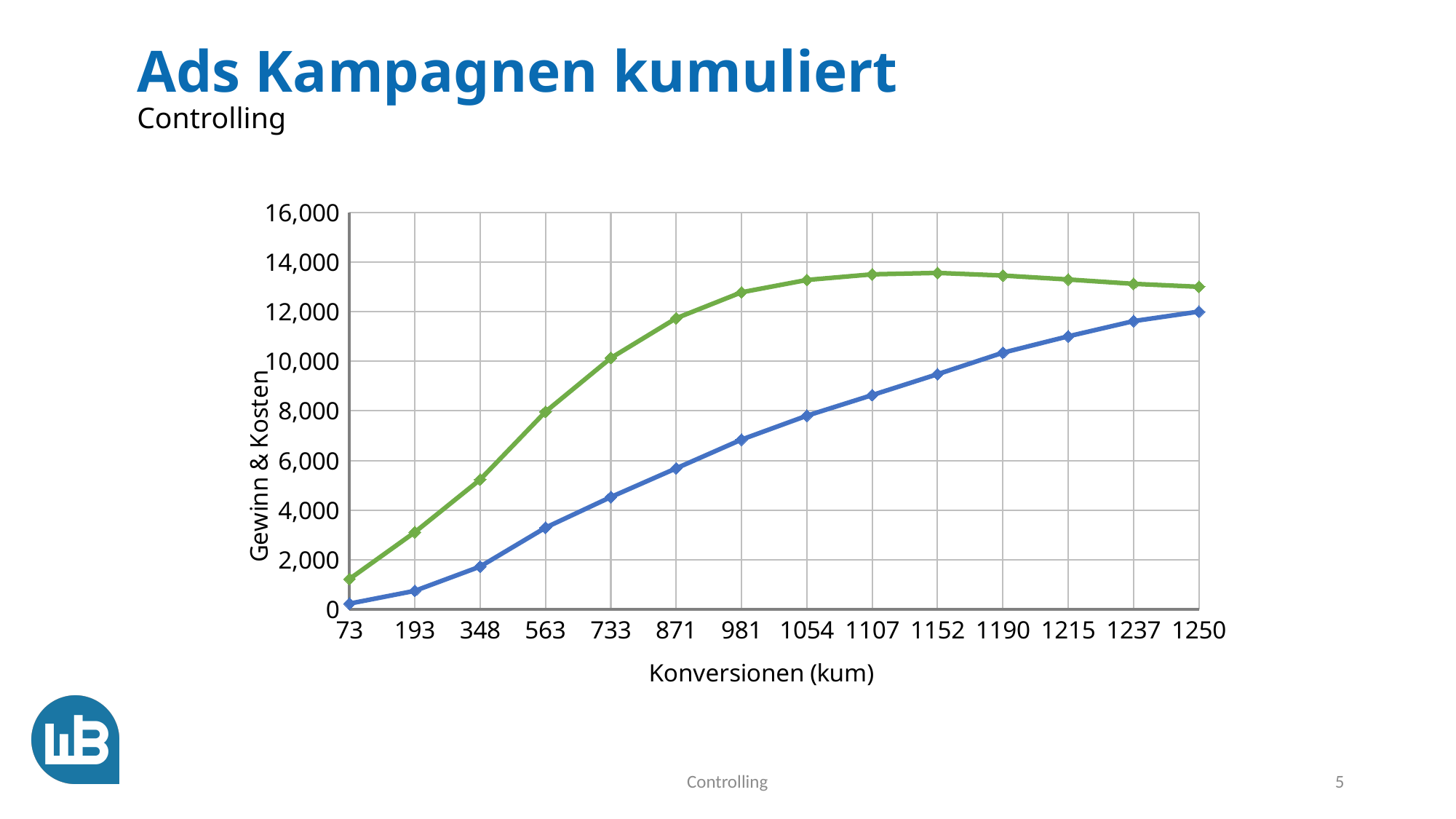
Is the value of the green line at 73 conversions greater or less than 2,000? less Does the blue line rise or fall as the x axis moves from 73 to 1250 conversions? rises At 871 conversions, which line has the higher value, the green line or the blue line? green line Does the green line rise or fall between 1152 and 1250 conversions? falls How many points are plotted along the x axis (Konversionen (kum))? 14 Is the value of the blue line at 563 conversions greater or less than 4,000? less What kind of chart is shown on the slide? line chart Is the value of the green line at 563 conversions greater or less than 6,000? greater At which x-axis value does the blue line reach its highest point? 1250 What is the title of the y axis? Gewinn & Kosten